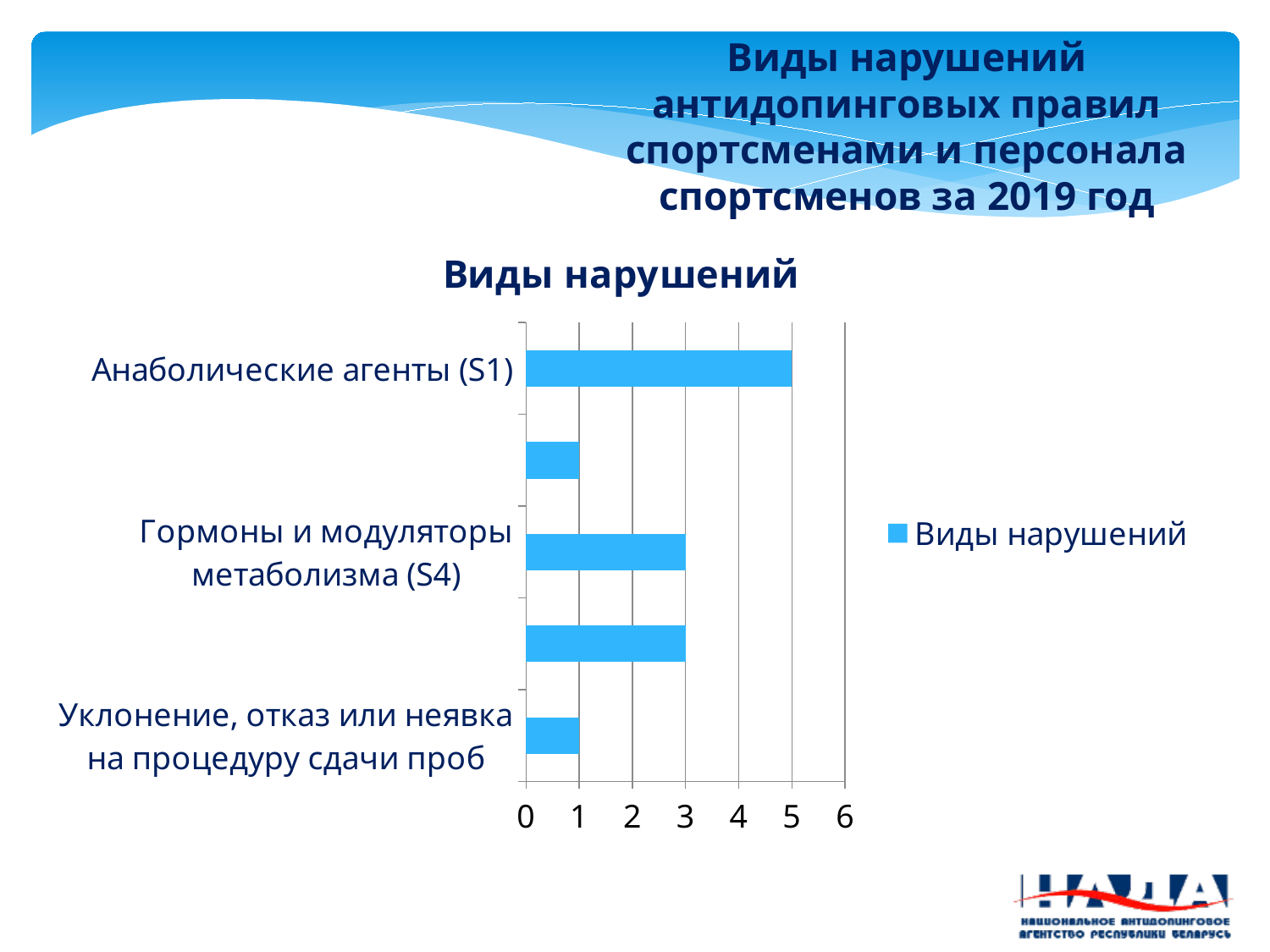
Which category has the highest value? Анаболические агенты (S1) What is the value for Анаболические агенты (S1)? 5 How many series does the legend list? 1 How many bars are plotted in the chart? 5 What is the difference between the values for Анаболические агенты (S1) and Гормоны и модуляторы метаболизма (S4)? 2 Is the value for Анаболические агенты (S1) greater or less than 4? greater What is the value for Уклонение, отказ или неявка на процедуру сдачи проб? 1 Is the value for Уклонение, отказ или неявка на процедуру сдачи проб greater or less than 2? less What is the value for Гормоны и модуляторы метаболизма (S4)? 3 Which is larger: the value for Анаболические агенты (S1) or the value for Гормоны и модуляторы метаболизма (S4)? Анаболические агенты (S1) What is the title of the chart? Виды нарушений What kind of chart is shown on the slide? bar chart